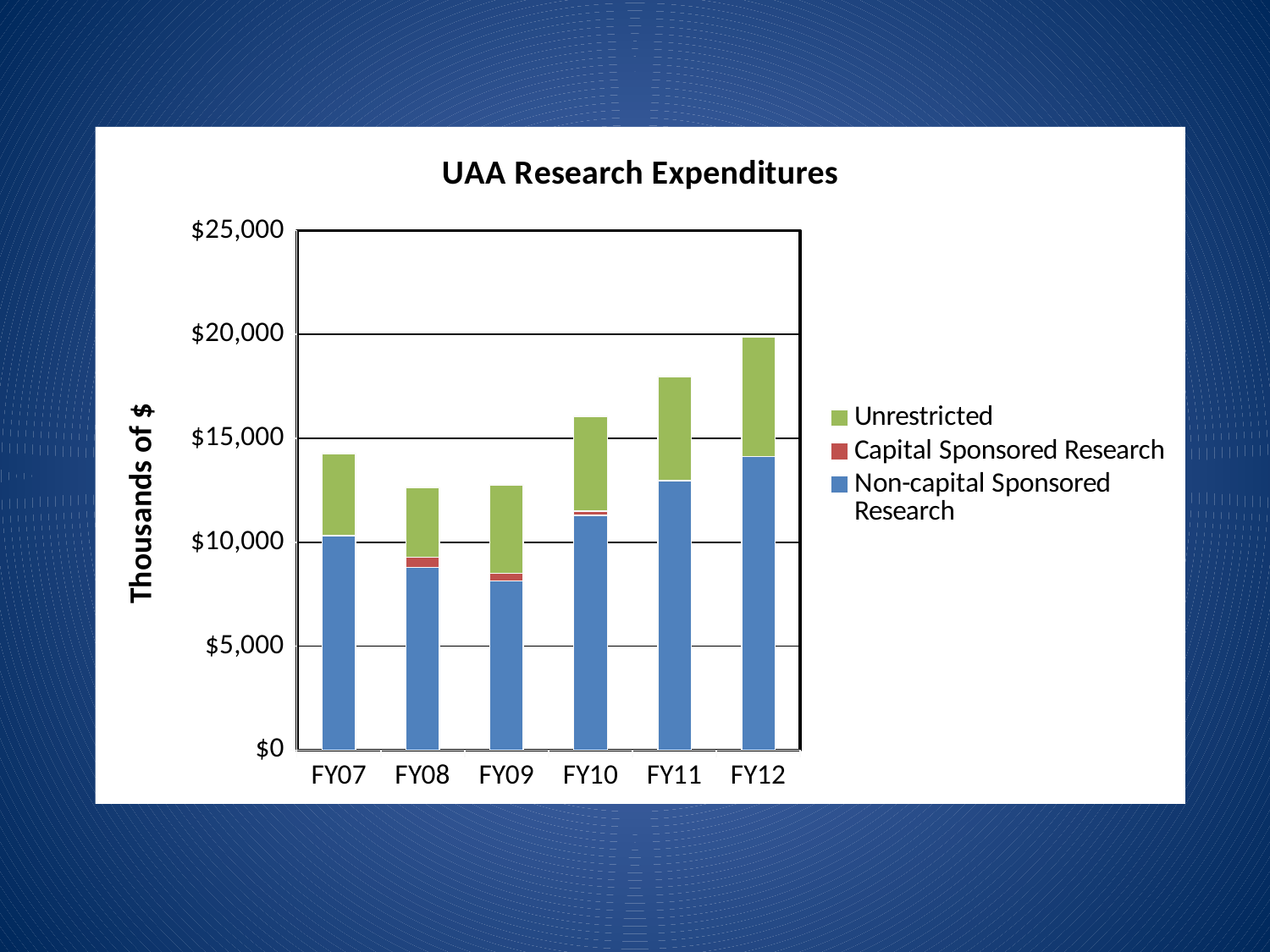
Is the total bar for FY12 greater or less than $15,000? greater Is the total bar for FY08 greater or less than $15,000? less Which fiscal year has the highest total research expenditures? FY12 How many fiscal years are shown on the x axis? 6 Which has the larger total research expenditures, FY07 or FY10? FY10 Is the Non-capital Sponsored Research value for FY11 greater or less than $10,000? greater What is the label on the y axis? Thousands of $ What kind of chart is shown on the slide? stacked bar chart How many series does the legend list? 3 Do total research expenditures rise or fall from FY09 to FY12? rise What is the title of the chart? UAA Research Expenditures